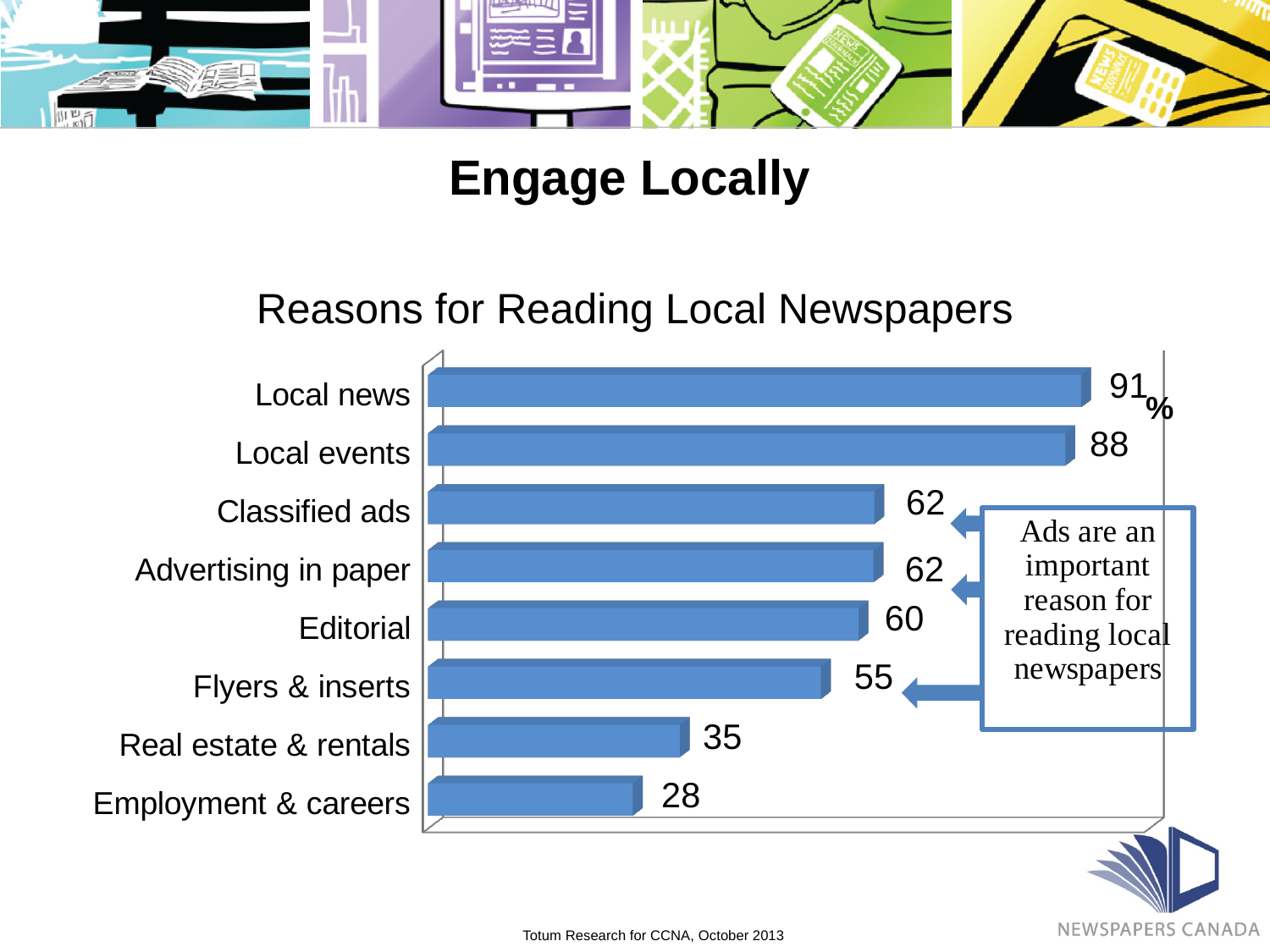
What is the value for Local news? 91 How many categories are shown in the chart? 8 What is the difference between the values for Local news and Local events? 3 What kind of chart is shown on the slide? Bar chart What is the title of the chart? Reasons for Reading Local Newspapers Which category has the highest value? Local news What is the value for Real estate & rentals? 35 What is the value for Flyers & inserts? 55 What is the difference between the values for Editorial and Employment & careers? 32 Which is larger, the value for Editorial or the value for Flyers & inserts? Editorial Which category has the lowest value? Employment & careers What is the value for Advertising in paper? 62